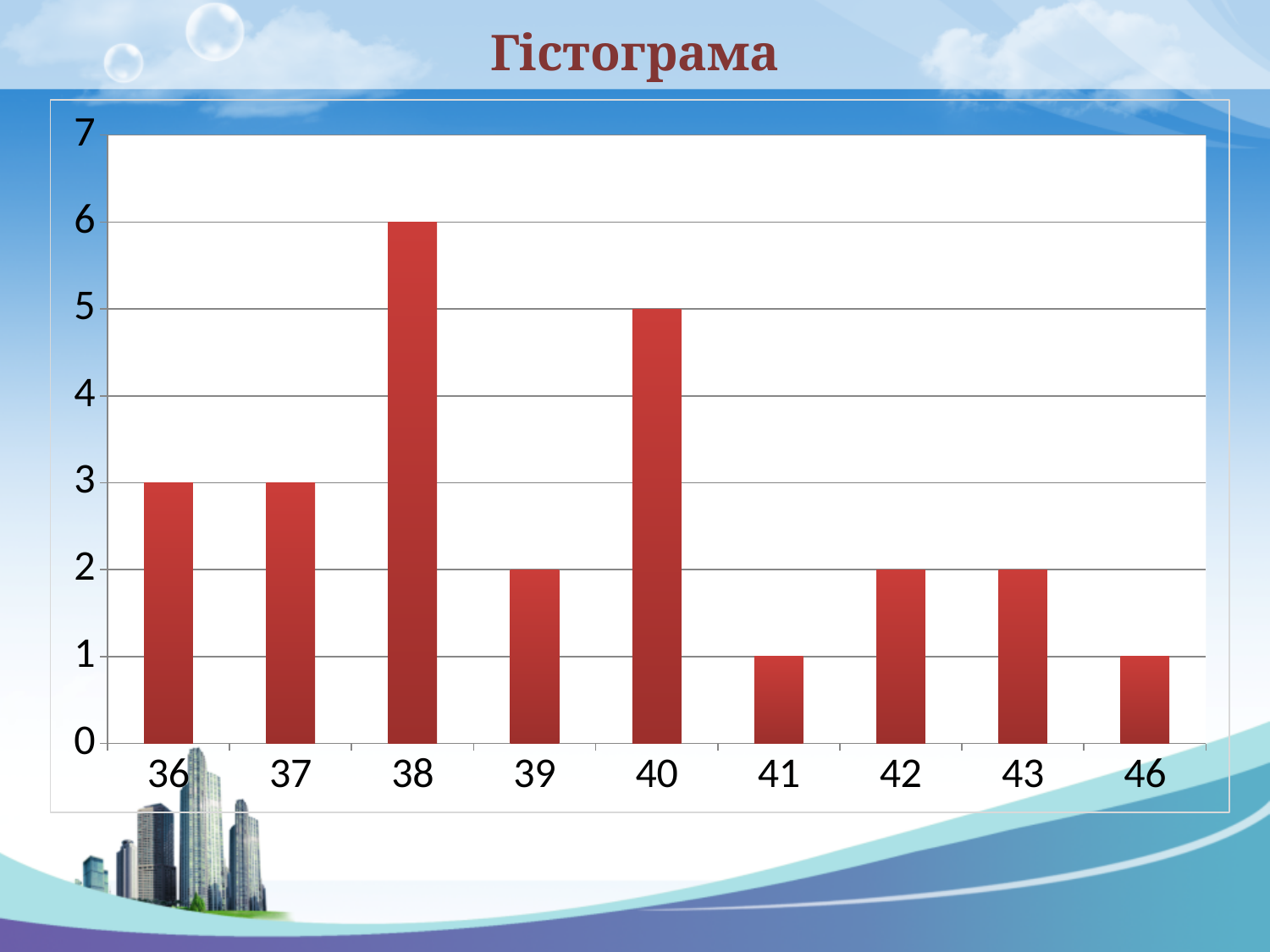
What is the difference between the values for 36 and 46? 2 Is the value for 40 greater or less than 4? greater What is the title of the slide? Гістограма What colour are the bars in the chart? red What is the value for category 41? 1 Which category has the highest bar? 38 What is the value for category 38? 6 What kind of chart is shown on the slide? bar chart How many categories are shown on the x axis? 9 What is the value for category 40? 5 What is the difference between the values for 38 and 40? 1 Which is larger, the value for 36 or the value for 39? 36